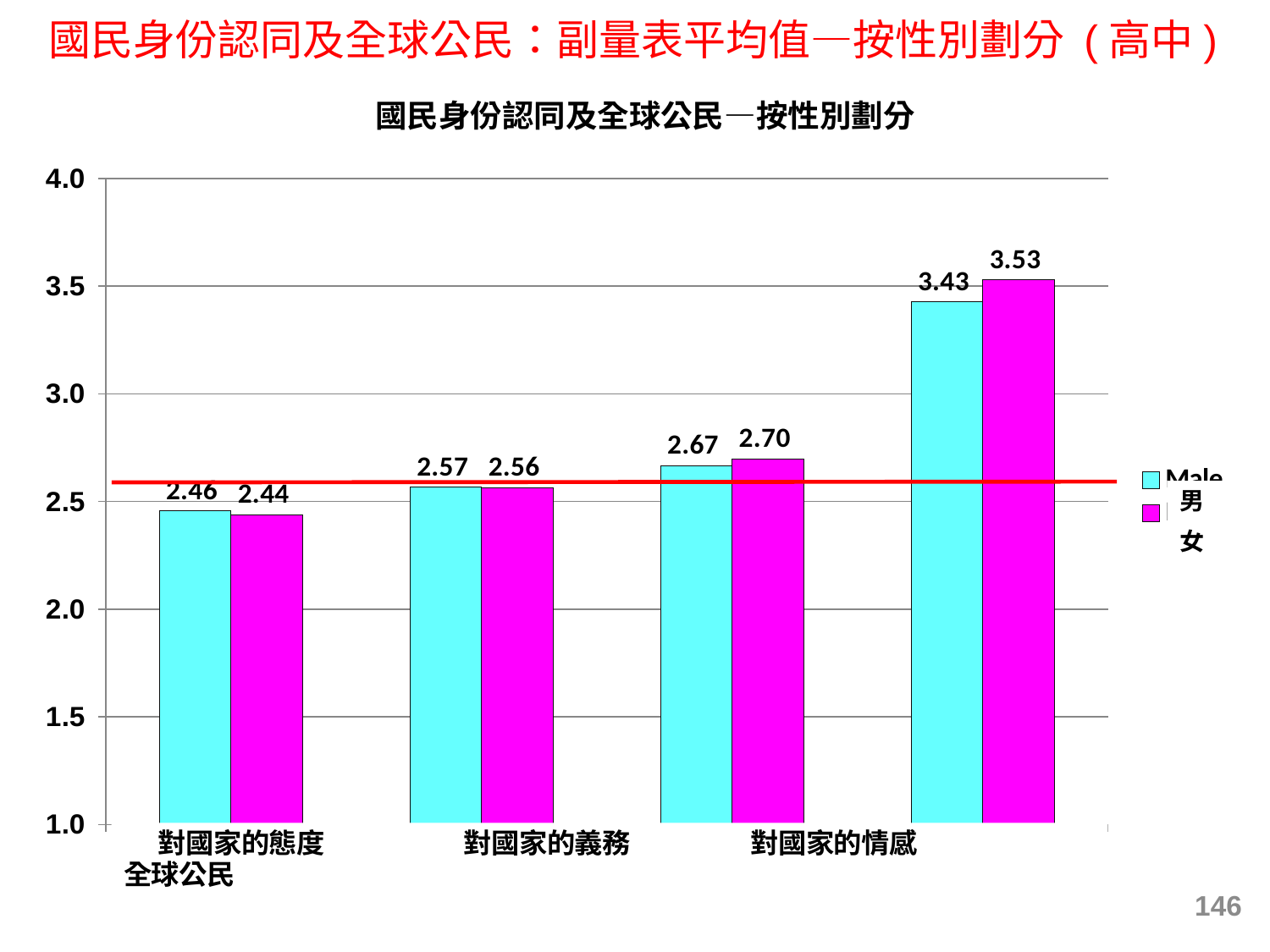
How many groups of bars are shown on the chart? 4 What is the value for 女 in the 對國家的情感 category? 2.70 How many series does the legend list? 2 In the 對國家的態度 category, which series has the larger value, 男 or 女? 男 What is the difference between the 女 and 男 values in the 對國家的情感 category? 0.03 What is the value for 男 in the rightmost group of bars? 3.43 What is the value for 男 in the 對國家的態度 category? 2.46 Which bar has the lowest value on the chart? 女 in 對國家的態度 (2.44) Which bar has the highest value on the chart? 女 in the rightmost group (3.53) What is the value for 女 in the 對國家的義務 category? 2.56 Is the 男 value in the rightmost group greater or less than 3.0? greater What kind of chart is shown on the slide? bar chart